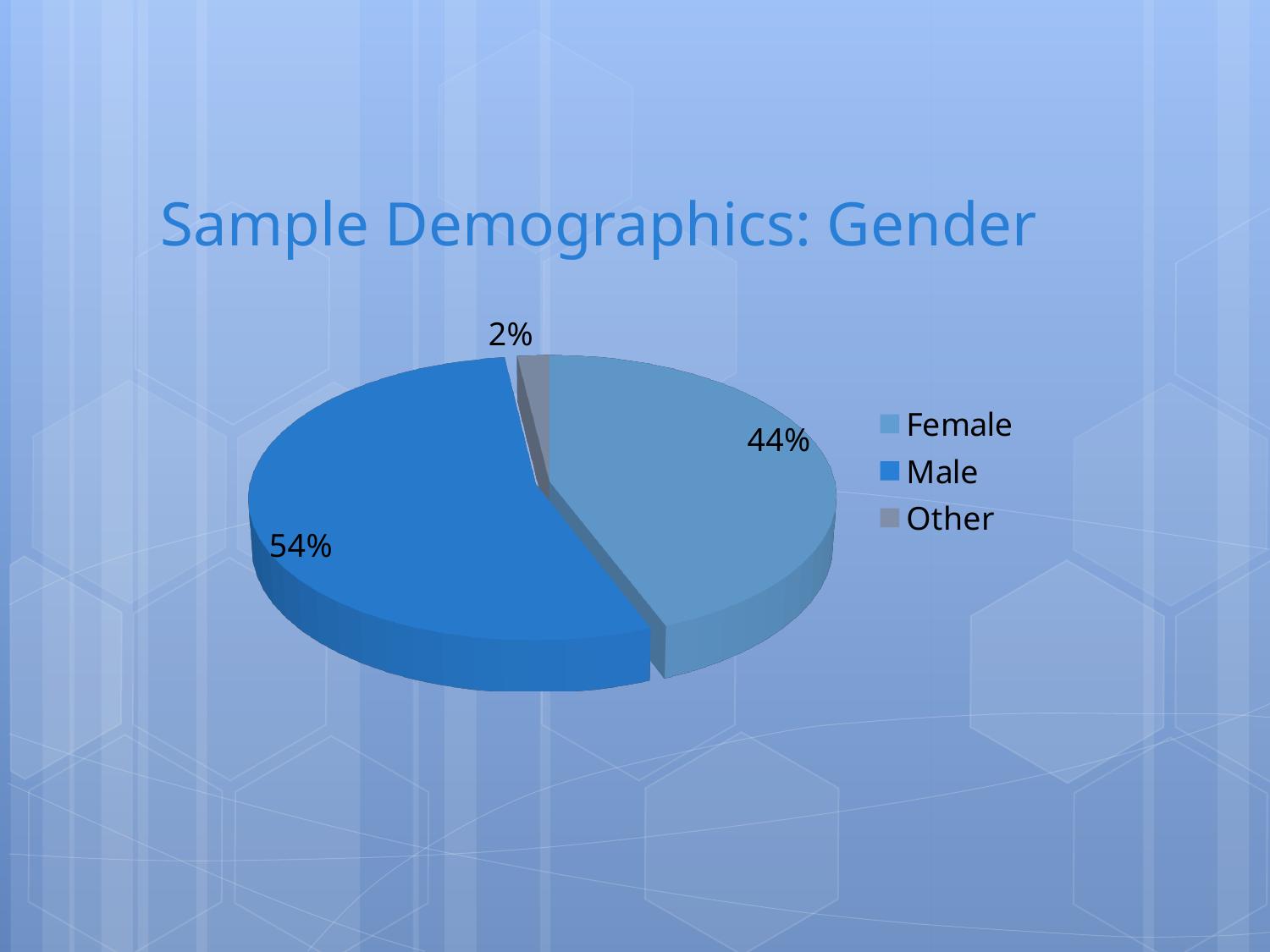
What percentage of the sample is Male? 54% How many categories does the pie chart show? 3 What kind of chart is shown on the slide? Pie chart What percentage of the sample is Female? 44% What is the title of the slide? Sample Demographics: Gender Which category is shown in grey in the legend? Other Which gender category has the smallest share of the sample? Other What is the combined share of Female and Other? 46% What percentage of the sample is Other? 2% What is the difference in percentage points between the Male and Female shares? 10 Which gender category has the largest share of the sample? Male Which is larger, the Female share or the Male share? Male